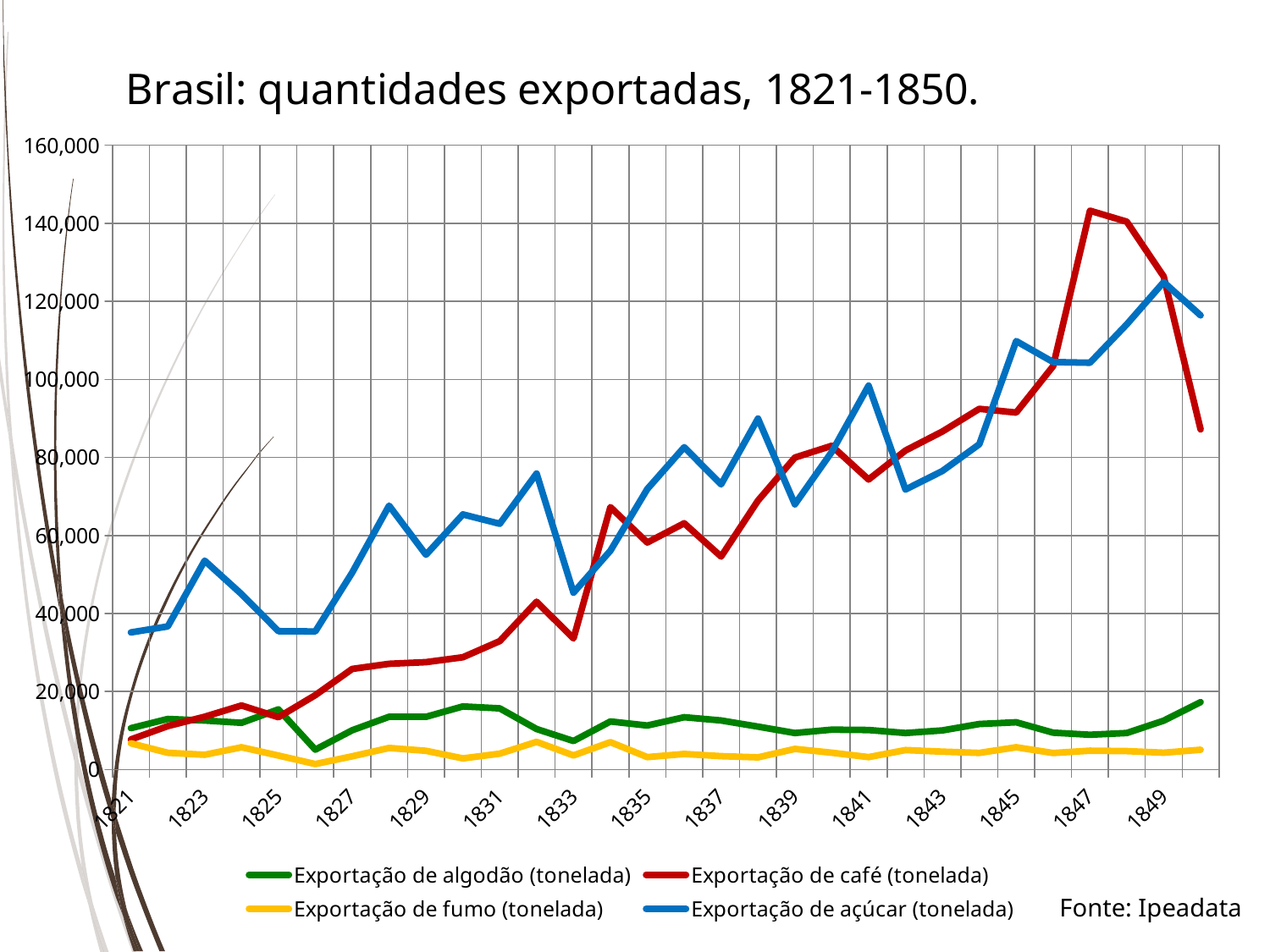
Does Exportação de café generally rise or fall from 1821 to 1847? rise Is the value for Exportação de café in 1850 greater or less than 100,000? less Is the value for Exportação de café in 1847 greater or less than 120,000? greater What is the title of the chart? Brasil: quantidades exportadas, 1821-1850. Which series stays lowest across the whole period? Exportação de fumo (tonelada) How many series does the legend list? 4 Is the value for Exportação de açúcar in 1821 greater or less than 40,000? less Which series reaches the highest value on the chart? Exportação de café (tonelada) What kind of chart is shown on the slide? line chart In 1821, which is larger: Exportação de açúcar or Exportação de café? Exportação de açúcar In 1847, which is larger: Exportação de café or Exportação de açúcar? Exportação de café